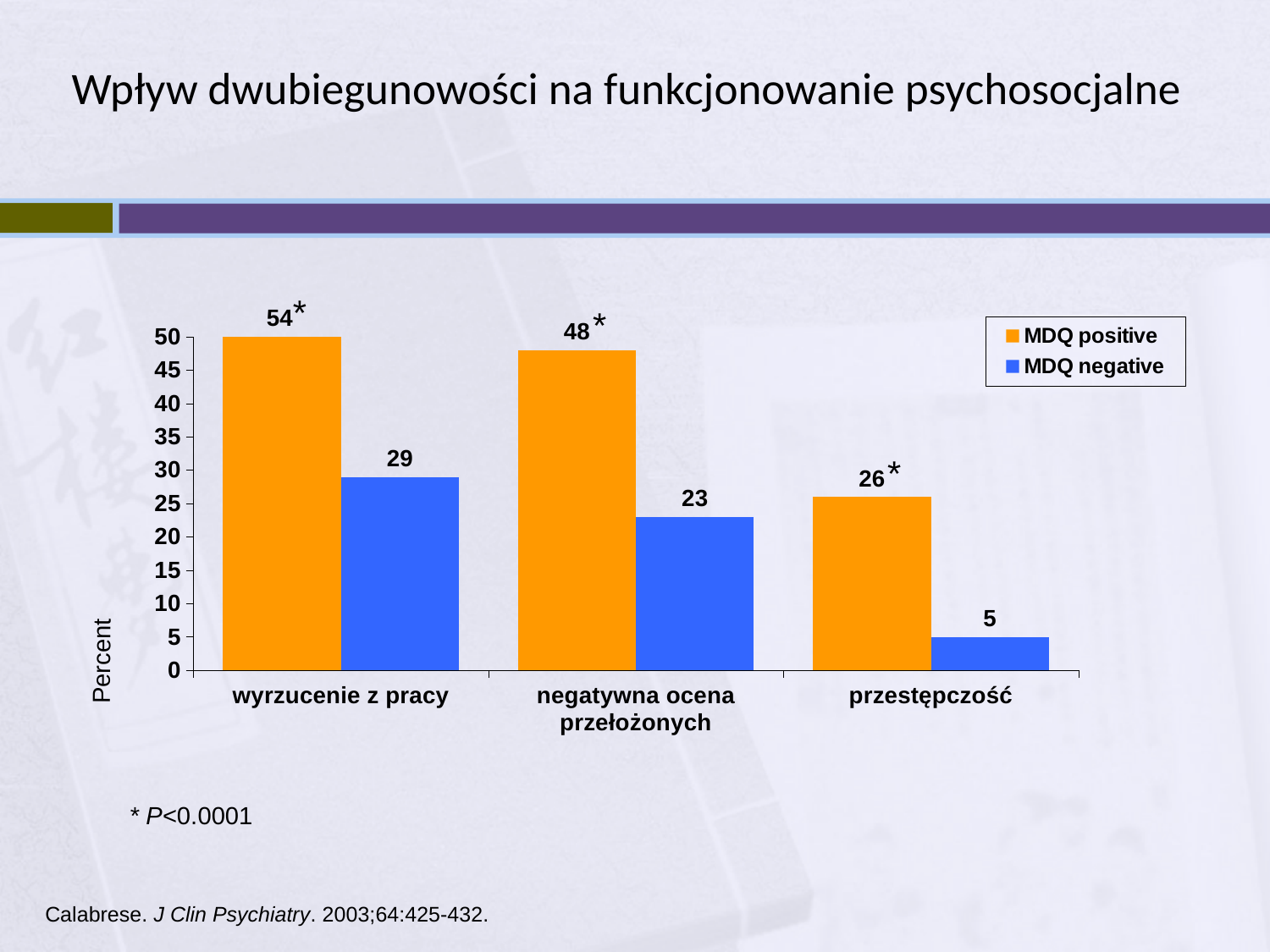
What is the label of the y axis? Percent What is the MDQ positive value for wyrzucenie z pracy? 54 What is the MDQ negative value for negatywna ocena przełożonych? 23 Which category has the lowest MDQ negative value? przestępczość Which is larger for negatywna ocena przełożonych: MDQ positive or MDQ negative? MDQ positive What is the MDQ negative value for przestępczość? 5 What kind of chart is shown on the slide? bar chart How many categories are shown on the x axis? 3 How many series does the legend list? 2 What is the difference between the MDQ positive and MDQ negative values for przestępczość? 21 Which category has the highest MDQ positive value? wyrzucenie z pracy What is the difference between the MDQ positive and MDQ negative values for wyrzucenie z pracy? 25